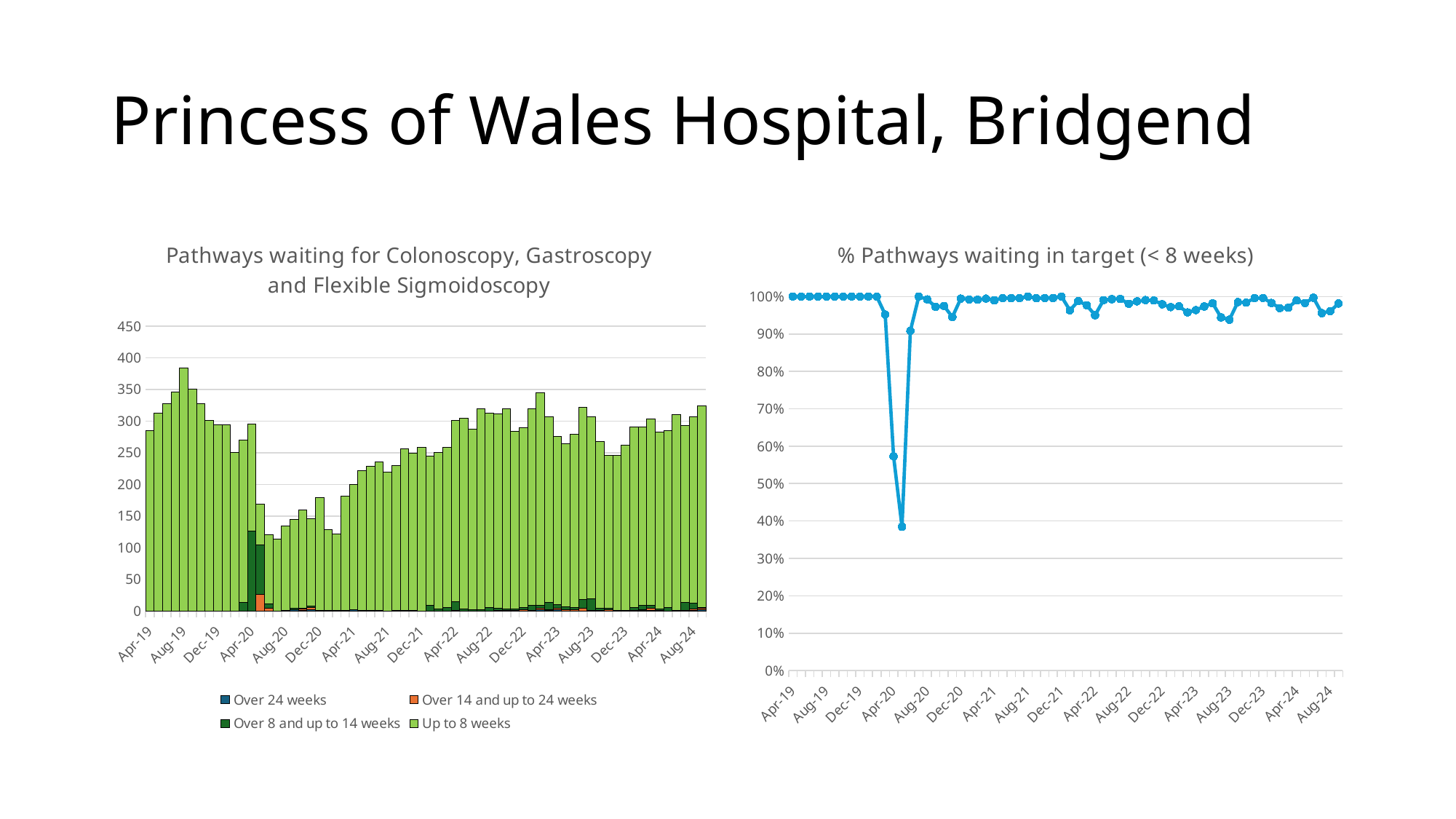
In the right chart, is the lowest value greater or less than 50%? less In the left chart, which series is shown in orange? Over 14 and up to 24 weeks In the right chart, around which month does the lowest point occur? May-20 How many series does the legend of the left chart list? 4 In the left chart, is the total for Apr-19 greater or less than 250? greater In the left chart, around which month does the tallest bar occur? Aug-19 What kind of chart is the right chart, '% Pathways waiting in target (< 8 weeks)'? Line chart In the left chart, is the total for Aug-20 greater or less than 200? less What kind of chart is the left chart, 'Pathways waiting for Colonoscopy, Gastroscopy and Flexible Sigmoidoscopy'? Stacked bar chart